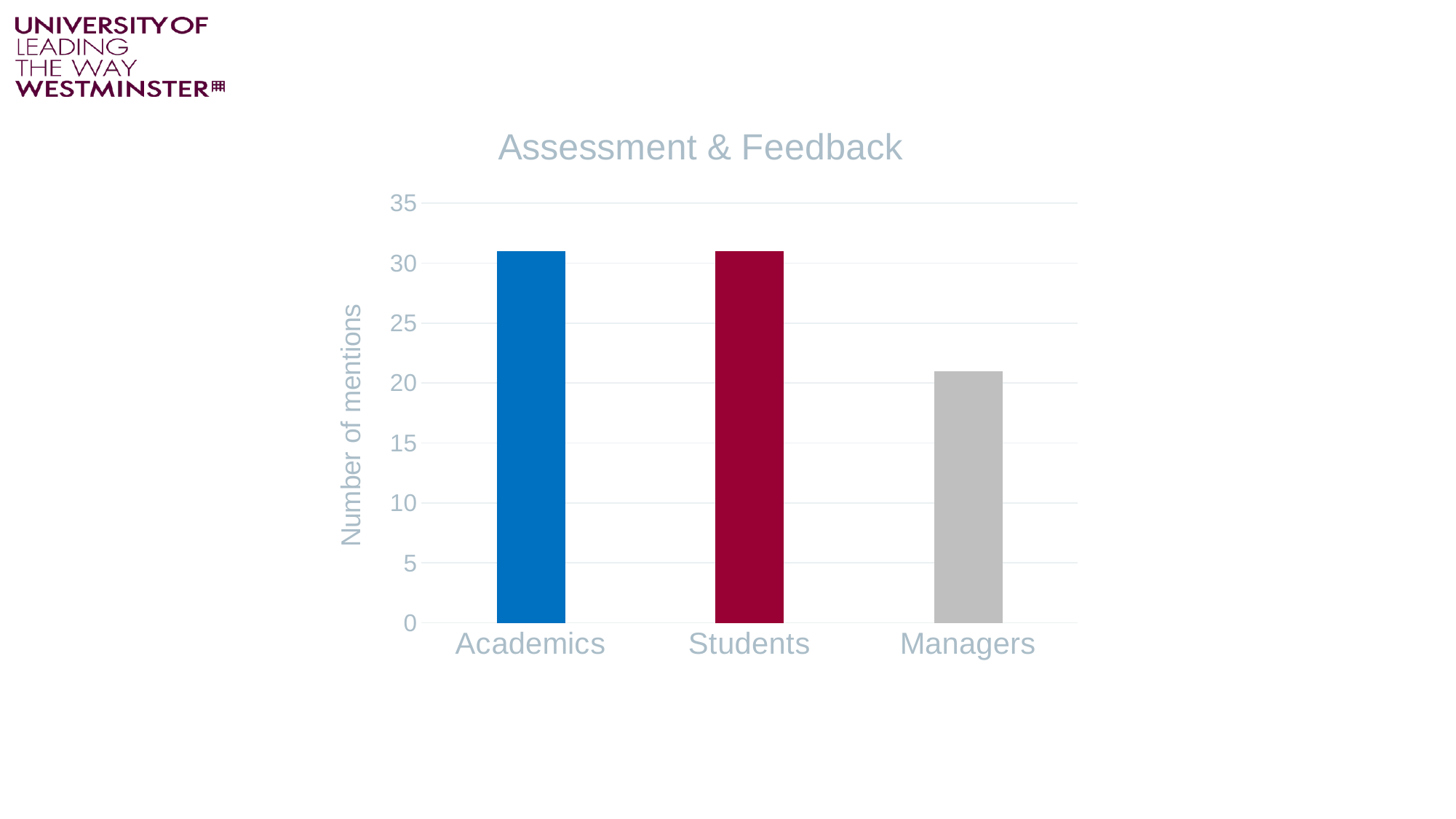
Which has more mentions, Students or Managers? Students Is the value for Students greater or less than 35? less Is the value for Managers greater or less than 25? less Which category has the lowest number of mentions? Managers What is the title of the chart? Assessment & Feedback How many categories are shown on the x axis of the chart? 3 What kind of chart is shown on the slide? bar chart What is the highest value shown on the vertical axis of the chart? 35 What is the label on the vertical axis of the chart? Number of mentions Which has more mentions, Academics or Managers? Academics